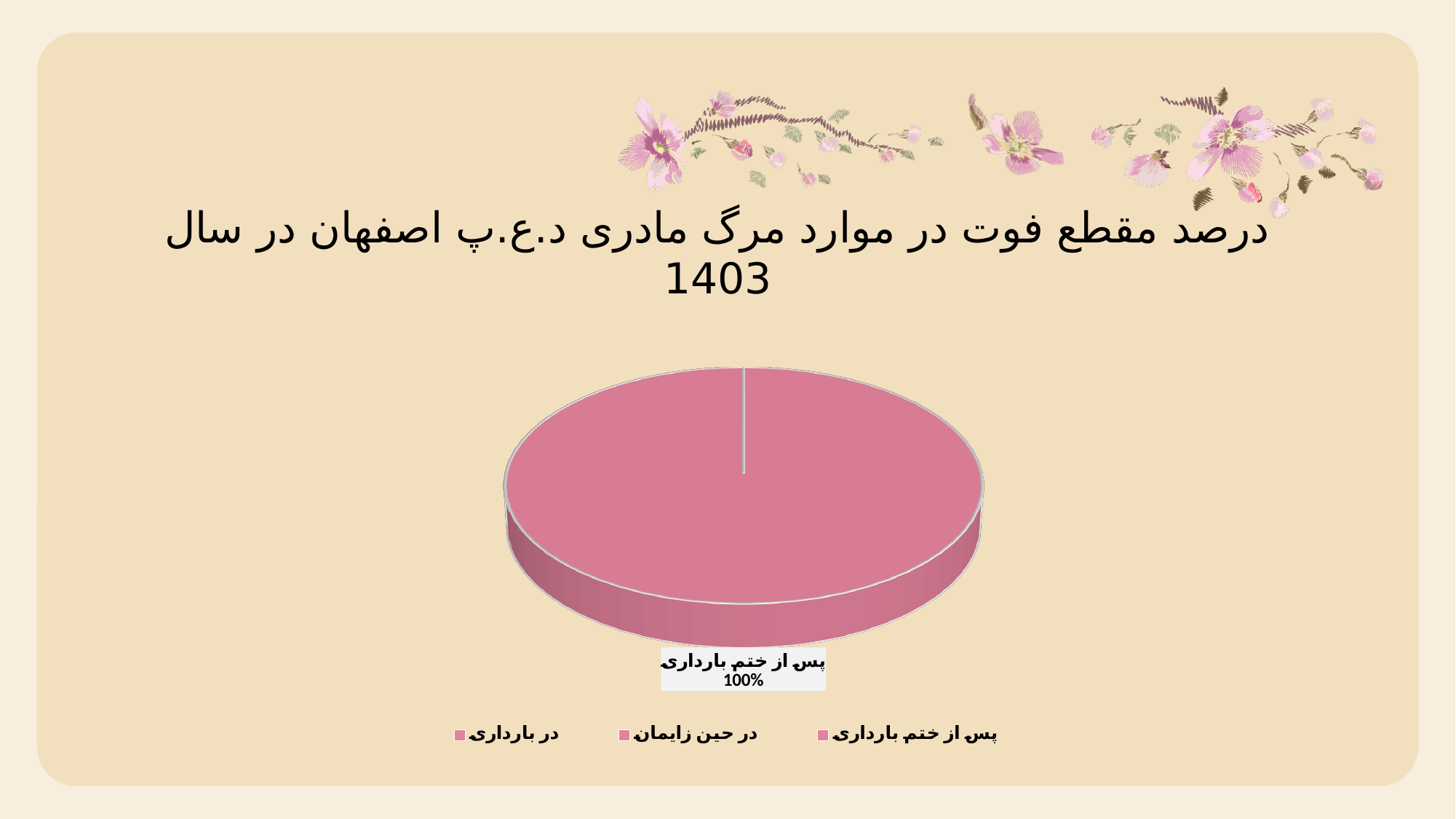
What share of the pie does the slice labelled "پس از ختم بارداری" represent? 100% How many entries does the legend of the pie chart list? 3 Which category accounts for the largest share of the pie? پس از ختم بارداری Is the share for "پس از ختم بارداری" greater or less than 50%? greater What value is printed on the data label of the pie chart? 100% What is the title of the chart slide? درصد مقطع فوت در موارد مرگ مادری د.ع.پ اصفهان در سال 1403 What kind of chart is shown on the slide? pie chart Which category's label is printed directly on the pie chart? پس از ختم بارداری Which year is named in the slide title? 1403